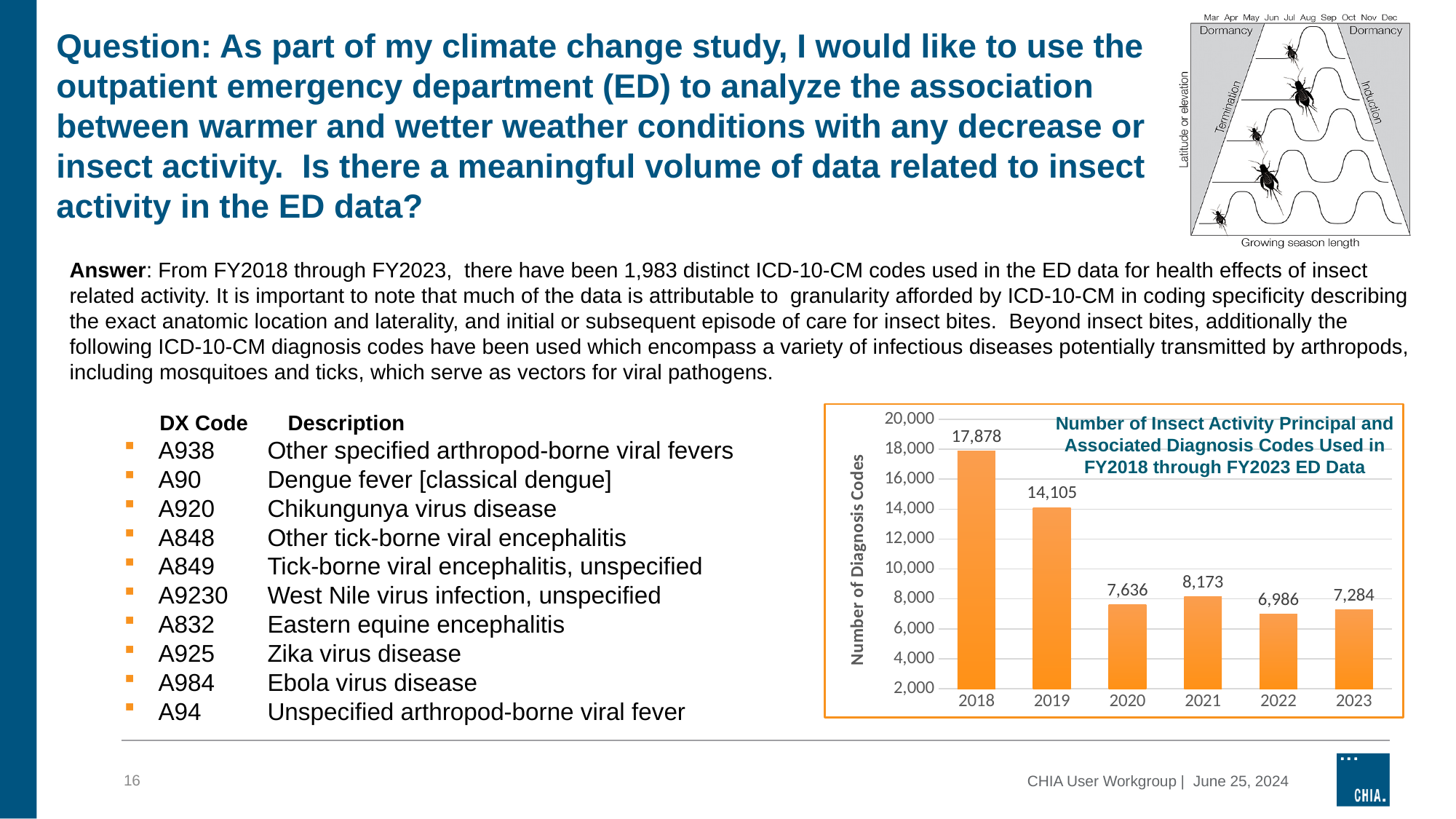
Is the value for 2019 greater or less than 12,000? greater What is the difference between the number of diagnosis codes in 2021 and 2020? 537 What is the number of diagnosis codes for 2023? 7,284 What kind of chart is shown on the slide? Bar chart What is the difference between the number of diagnosis codes in 2018 and 2019? 3,773 Which year has more diagnosis codes, 2020 or 2023? 2020 What is the number of diagnosis codes for 2021? 8,173 Which year has the lowest number of diagnosis codes? 2022 How many years are shown on the x axis of the chart? 6 What is the label of the vertical axis of the chart? Number of Diagnosis Codes What is the number of diagnosis codes for 2018? 17,878 Which year has the highest number of diagnosis codes? 2018